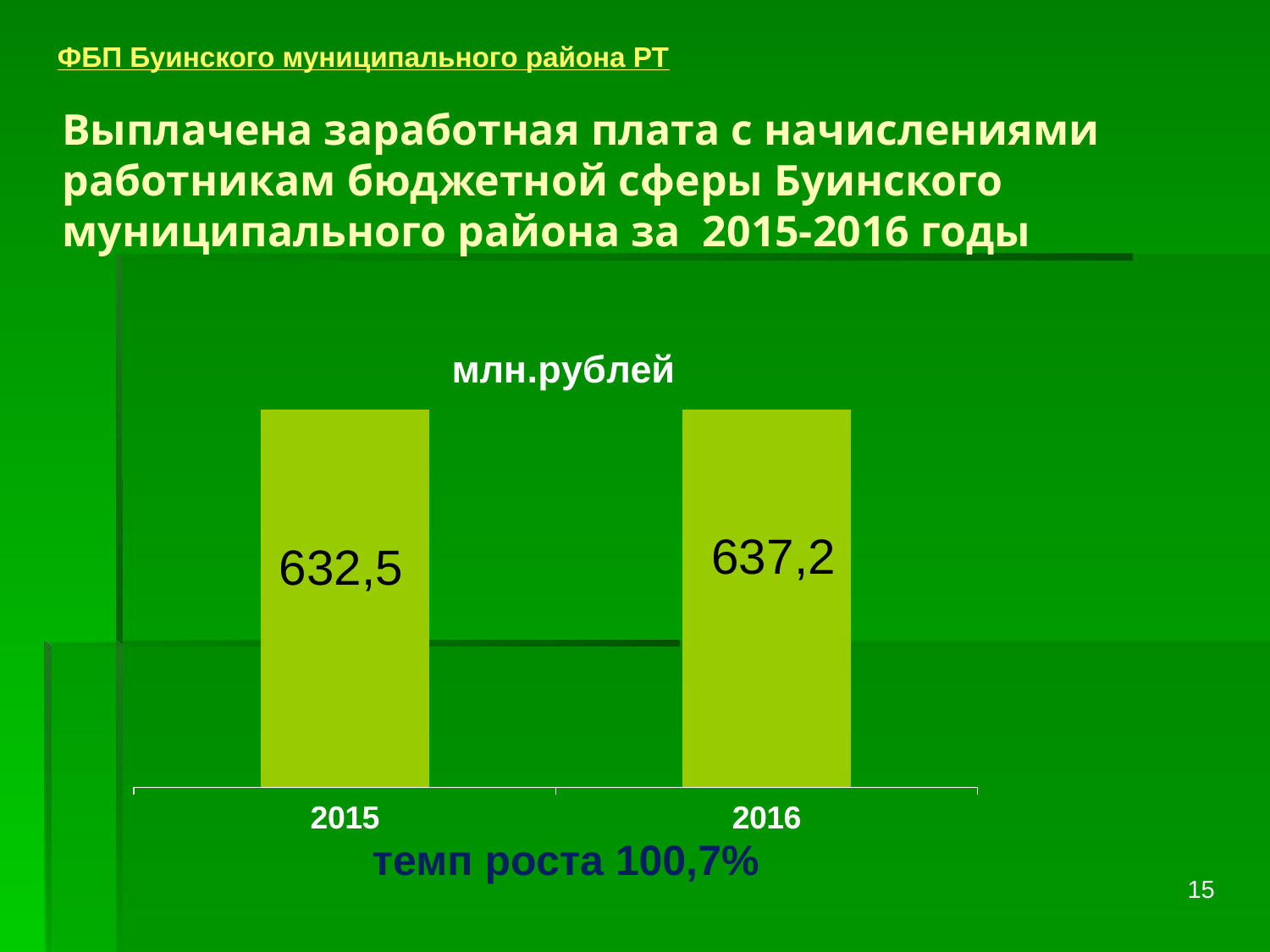
What is the value for 2015? 632,5 Which year has the lower value? 2015 Do the values rise or fall from 2015 to 2016? Rise Is the value for 2016 larger than the value for 2015? Yes What kind of chart is shown on the slide? Bar chart What unit is shown above the chart? млн.рублей What is the value for 2016? 637,2 Which year has the higher value? 2016 What is the difference between the values for 2016 and 2015? 4,7 What growth rate (темп роста) is stated below the chart? 100,7% How many bars are shown in the chart? 2